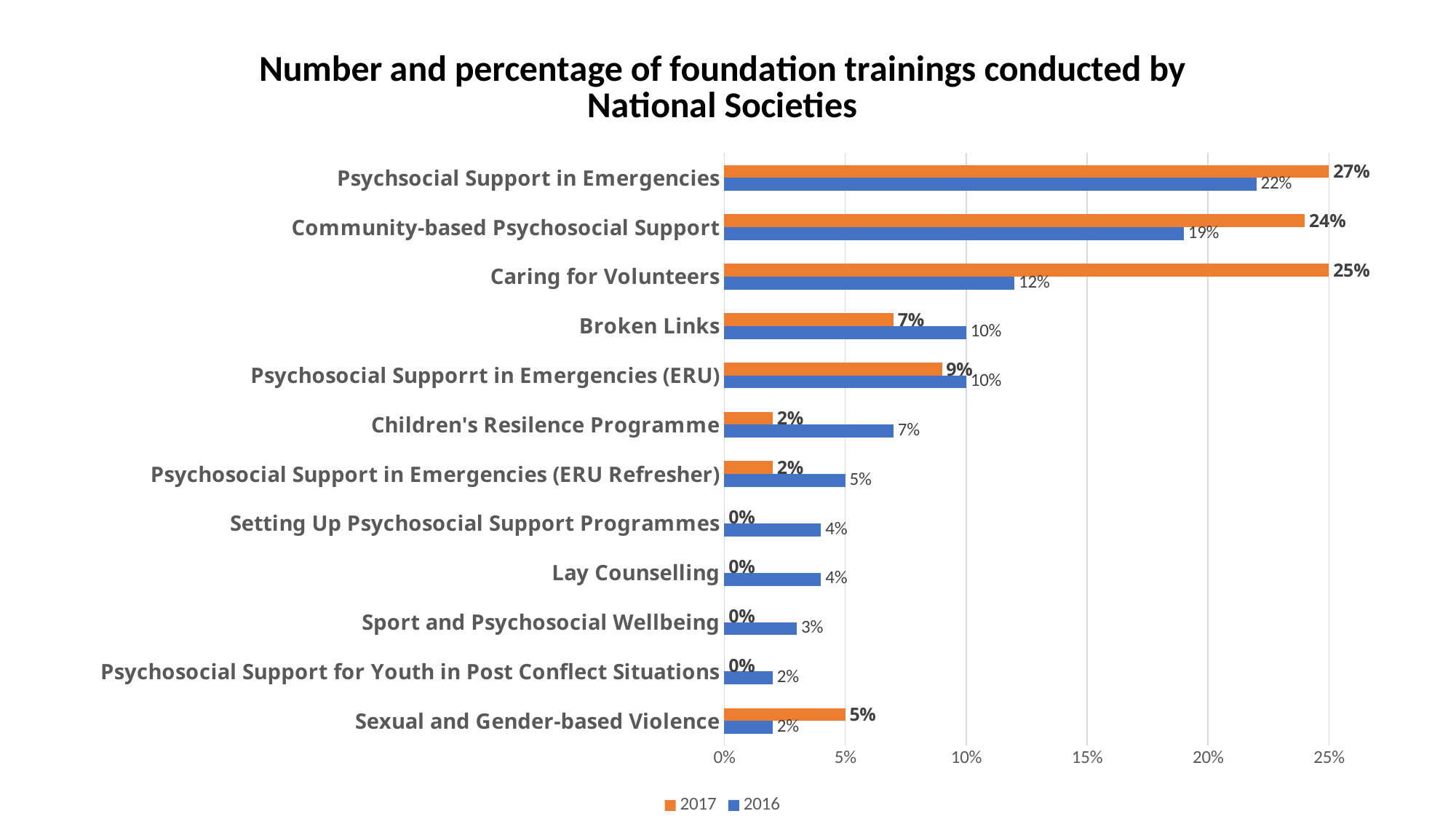
Which category has the highest 2017 value? Psychsocial Support in Emergencies Which colour represents the 2017 series? Orange Which is larger for Broken Links, the 2017 value or the 2016 value? 2016 What is the 2016 value for Community-based Psychosocial Support? 19% What is the 2017 value for Sexual and Gender-based Violence? 5% What kind of chart is shown on the slide? Bar chart How many series does the legend list? 2 Which category has the highest 2016 value? Psychsocial Support in Emergencies How many categories are shown on the chart? 12 What is the 2017 value for Caring for Volunteers? 25% What is the difference between the 2017 and 2016 values for Caring for Volunteers? 13% What is the 2016 value for Children's Resilence Programme? 7%